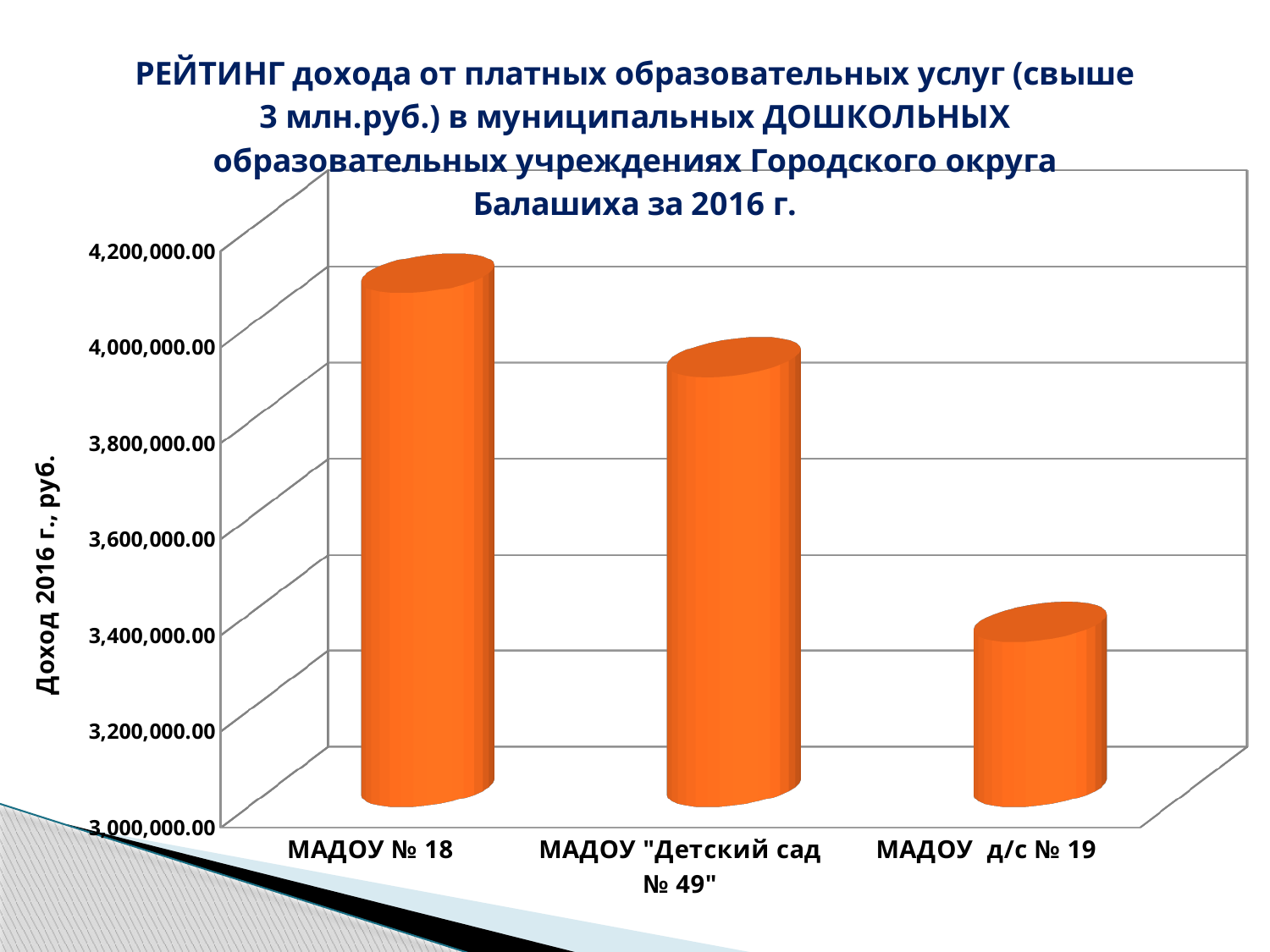
Which institution has the highest income in the chart? МАДОУ № 18 Which institution has the lowest income in the chart? МАДОУ д/с № 19 What kind of chart is shown on the slide? bar chart What colour are the bars in the chart? orange Which has the larger income: МАДОУ № 18 or МАДОУ "Детский сад № 49"? МАДОУ № 18 Which has the larger income: МАДОУ "Детский сад № 49" or МАДОУ д/с № 19? МАДОУ "Детский сад № 49" How many institutions (categories) are shown in the chart? 3 What is the label of the vertical axis? Доход 2016 г., руб. Is the value for МАДОУ № 18 greater or less than 4,000,000.00? greater Do the values rise or fall from left to right across the chart? fall Is the value for МАДОУ д/с № 19 greater or less than 3,600,000.00? less Is the value for МАДОУ "Детский сад № 49" greater or less than 4,000,000.00? less